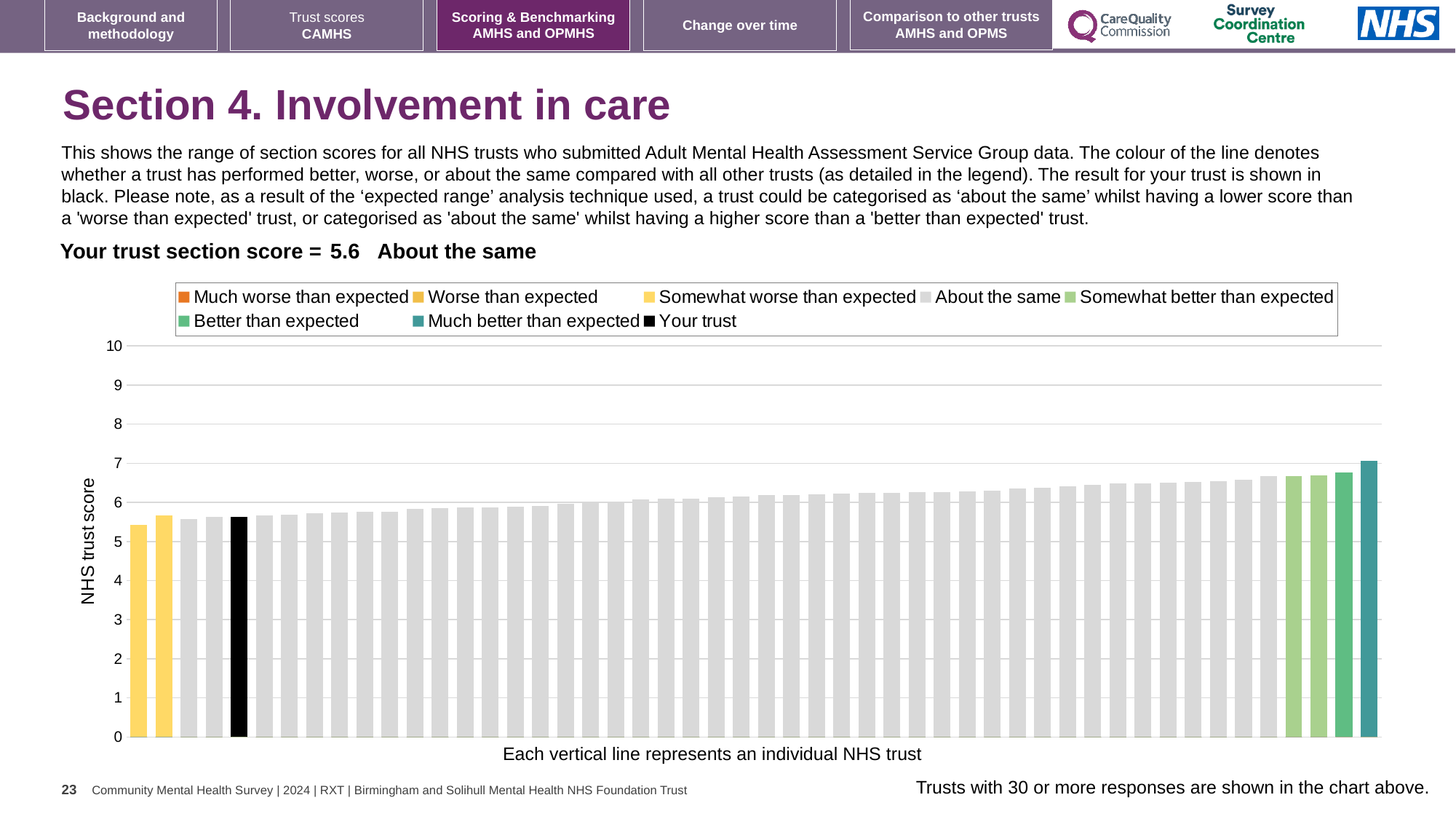
What is the label on the vertical axis of the chart? NHS trust score Which legend category does the lowest bar belong to? Somewhat worse than expected Do the bar values rise or fall from left to right along the x axis? Rise Is the highest bar in the chart greater or less than 8? less What is the section score for your trust shown on the slide? 5.6 Is the value for your trust (the black bar) greater or less than 5? greater How many entries does the chart legend list? 8 Which legend category does the highest bar belong to? Much better than expected What kind of chart is shown on the slide? Bar chart How many bars are coloured as 'Somewhat worse than expected'? 2 Which is larger, the leftmost bar or the rightmost bar? The rightmost bar Is the lowest bar in the chart greater or less than 6? less